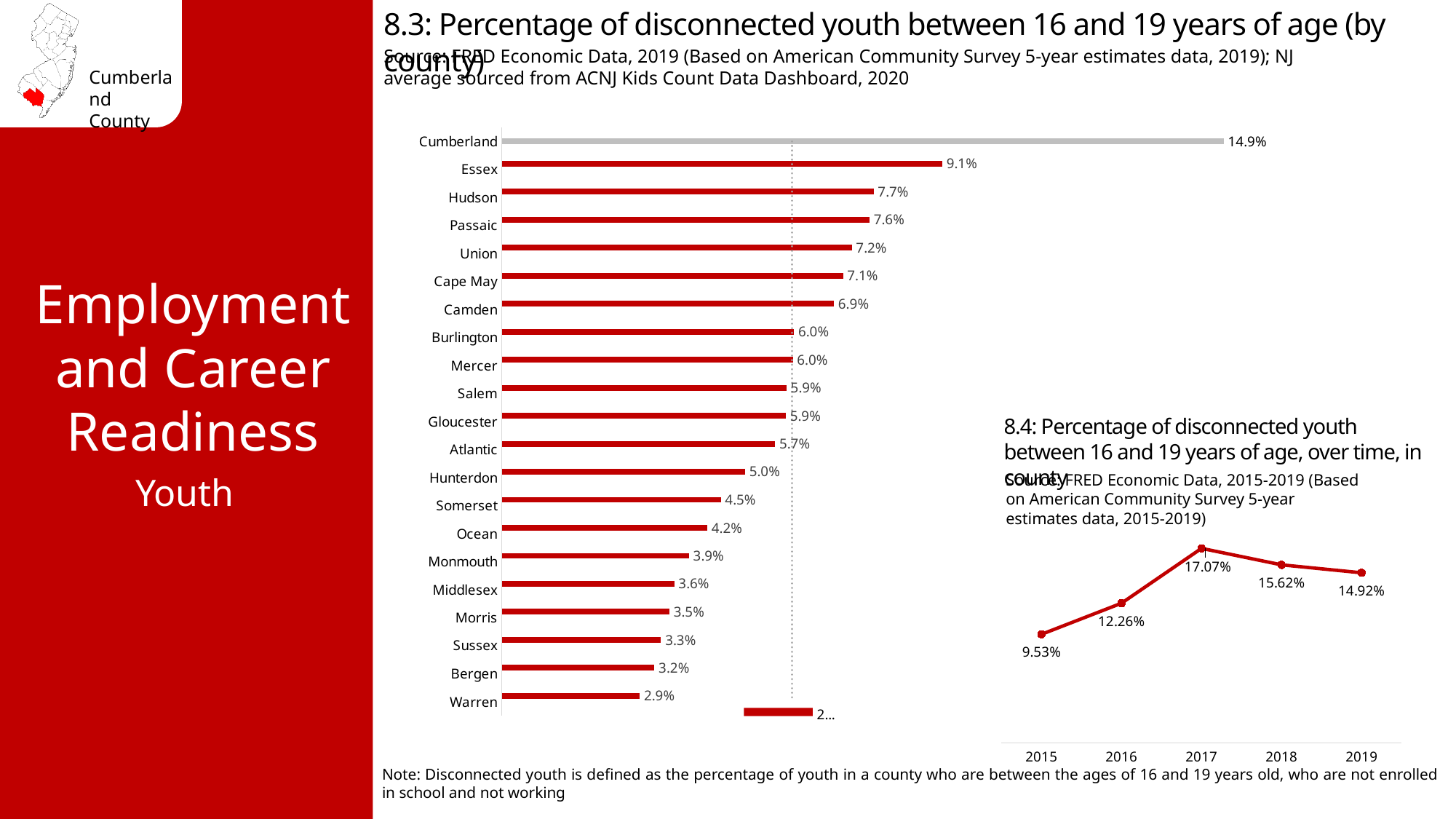
In chart 8.3 (percentage of disconnected youth by county), which county has the highest value? Cumberland In chart 8.3 (percentage of disconnected youth by county), which county has the lowest value? Warren In chart 8.3 (percentage of disconnected youth by county), which is larger, the value for Hudson or the value for Ocean? Hudson In chart 8.3 (percentage of disconnected youth by county), what is the value for Cumberland? 14.9% In chart 8.3 (percentage of disconnected youth by county), what is the difference between Cumberland and Essex? 5.8% In chart 8.4 (percentage of disconnected youth over time), what is the value for 2015? 9.53% In chart 8.4 (percentage of disconnected youth over time), what is the value for 2017? 17.07% In chart 8.3 (percentage of disconnected youth by county), what kind of chart is shown? Bar chart In chart 8.4 (percentage of disconnected youth over time), do the values rise or fall from 2017 to 2019? Fall In chart 8.4 (percentage of disconnected youth over time), which year has the highest value? 2017 In chart 8.3 (percentage of disconnected youth by county), what is the value for Essex? 9.1% In chart 8.4 (percentage of disconnected youth over time), how many data points are plotted? 5